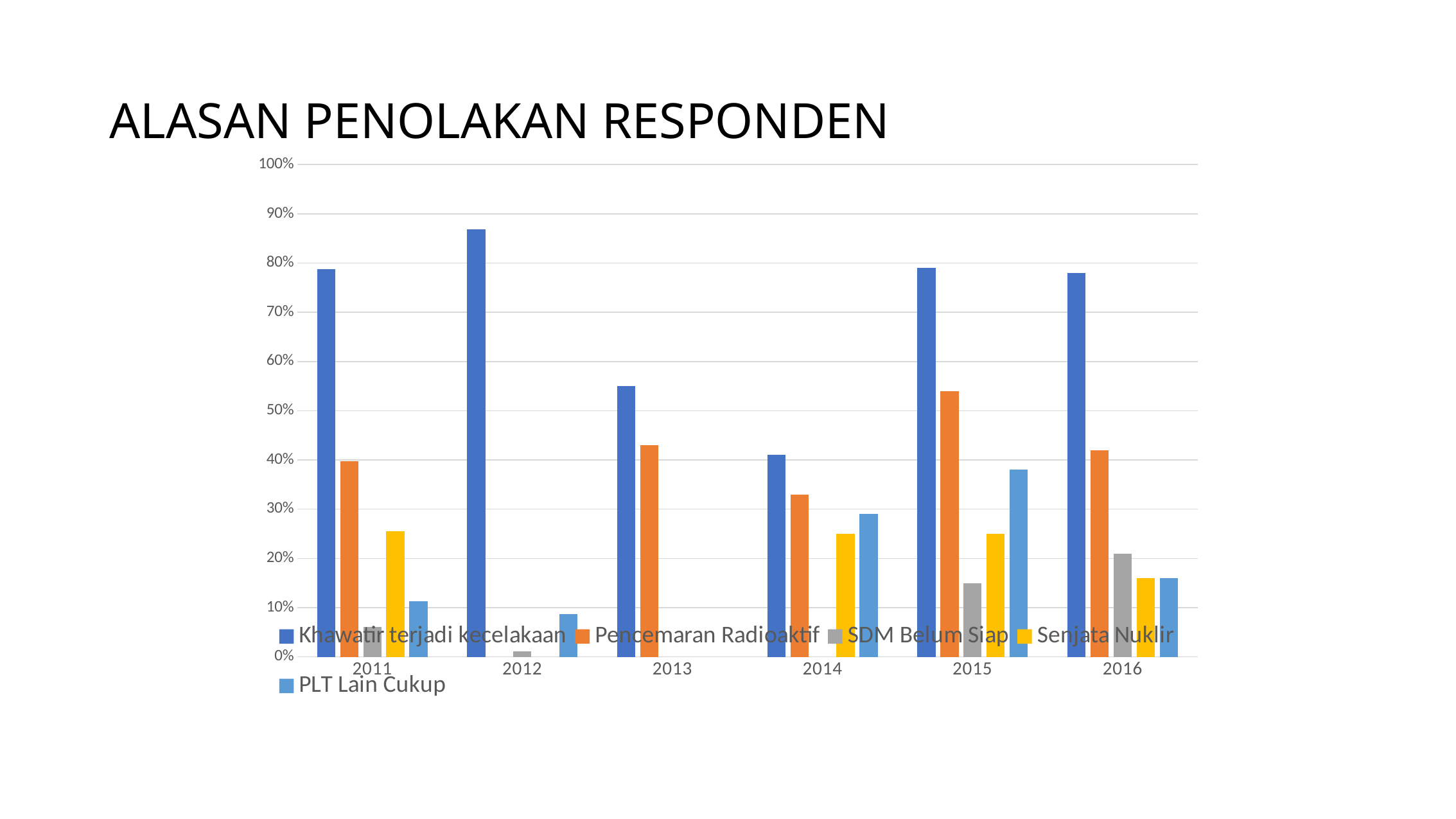
Does the value for Khawatir terjadi kecelakaan rise or fall from 2012 to 2014? fall In which year is the value for Pencemaran Radioaktif highest? 2015 Is the value for Pencemaran Radioaktif in 2015 greater or less than 50%? greater How many years are shown on the x axis? 6 In which year is the value for Khawatir terjadi kecelakaan highest? 2012 What is the title of the chart? ALASAN PENOLAKAN RESPONDEN Is the value for Khawatir terjadi kecelakaan in 2012 greater or less than 80%? greater In 2013, which is larger: Khawatir terjadi kecelakaan or Pencemaran Radioaktif? Khawatir terjadi kecelakaan In which year is the value for Khawatir terjadi kecelakaan lowest? 2014 How many series does the legend list? 5 What kind of chart is shown on the slide? bar chart Is the value for PLT Lain Cukup in 2015 greater or less than 40%? less